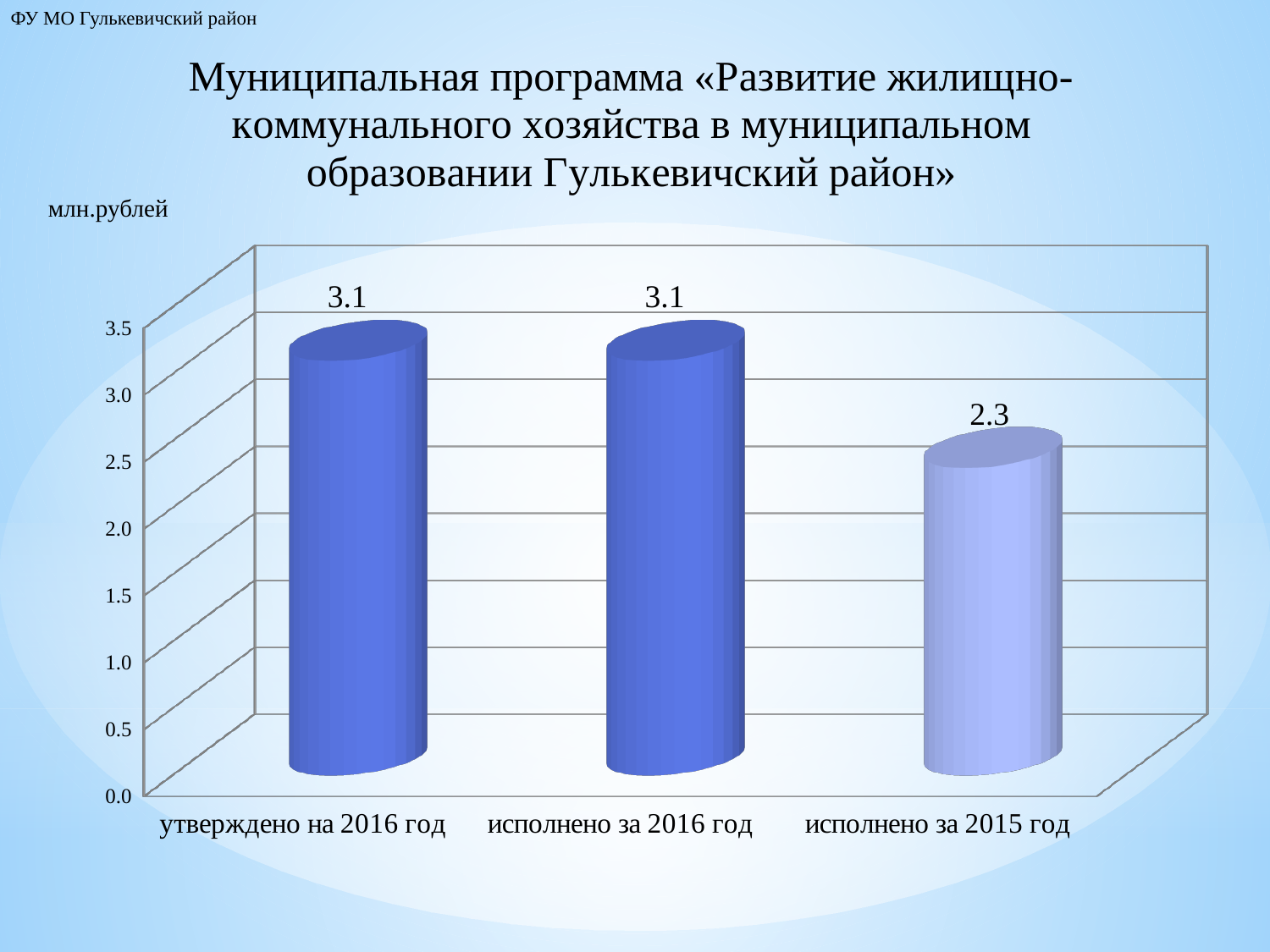
How many categories are shown in the chart? 3 Which is larger: «утверждено на 2016 год» or «исполнено за 2015 год»? утверждено на 2016 год Is the value for «исполнено за 2016 год» greater or less than 3.0? greater What is the value for «исполнено за 2015 год»? 2.3 What unit is indicated for the values in the chart? млн.рублей Which category has the lowest value? исполнено за 2015 год Is the value for «исполнено за 2015 год» greater or less than 2.5? less What is the value for «утверждено на 2016 год»? 3.1 What is the highest value shown on the vertical axis? 3.5 What is the value for «исполнено за 2016 год»? 3.1 What kind of chart is shown on the slide? bar chart What is the difference between «исполнено за 2016 год» and «исполнено за 2015 год»? 0.8